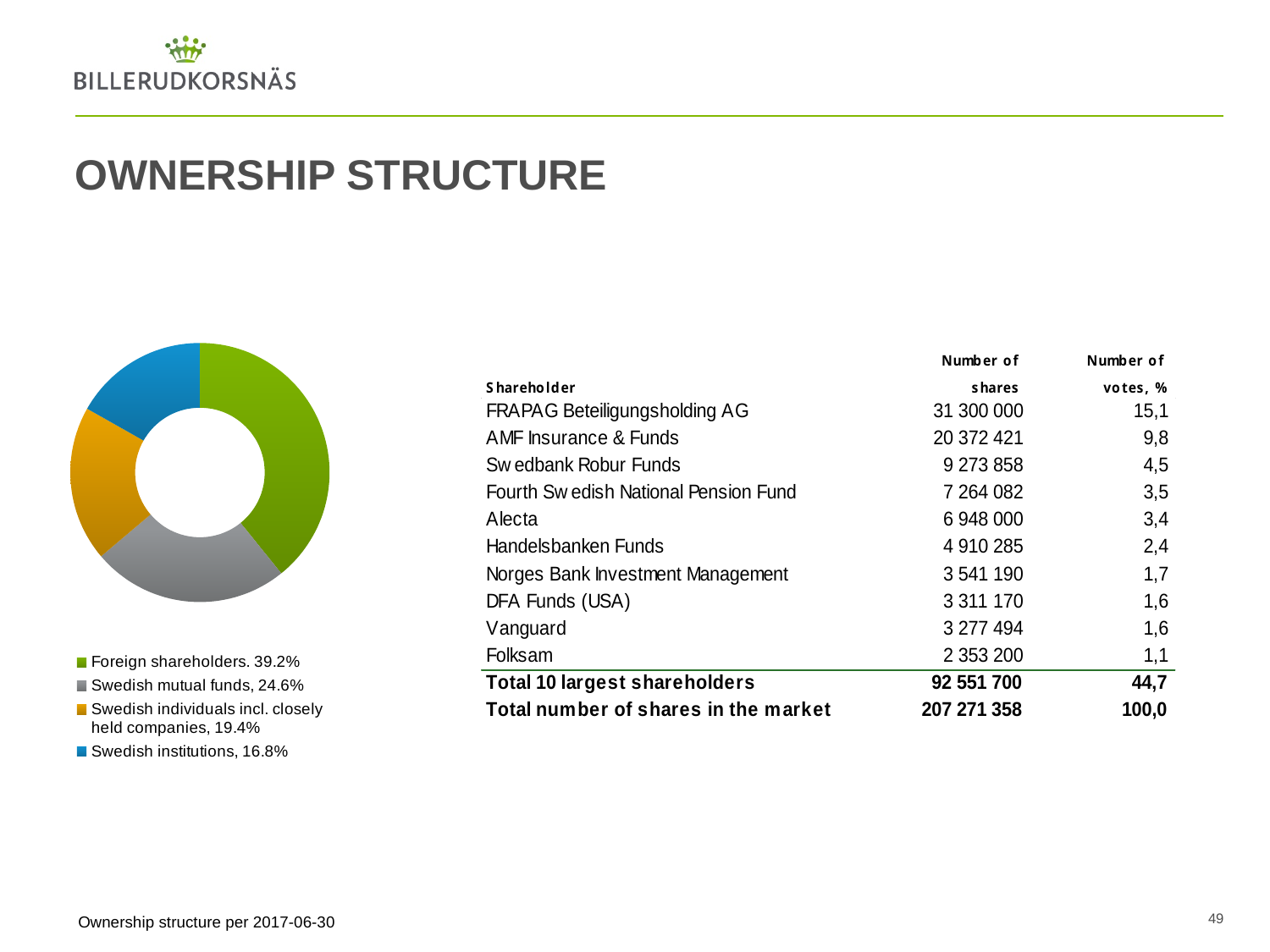
How many categories does the donut chart show? 4 What share of the donut chart is Swedish mutual funds? 24.6% What is the difference in percentage points between Foreign shareholders and Swedish mutual funds in the donut chart? 14.6 percentage points What colour represents Swedish institutions in the donut chart? Blue What share of the donut chart is Swedish individuals incl. closely held companies? 19.4% What share of the donut chart is Swedish institutions? 16.8% Which category has the largest share in the donut chart? Foreign shareholders Which category has the smallest share in the donut chart? Swedish institutions What is the difference in percentage points between Foreign shareholders and Swedish institutions in the donut chart? 22.4 percentage points In the donut chart, which is larger: Swedish mutual funds or Swedish individuals incl. closely held companies? Swedish mutual funds What kind of chart is shown on the left of the slide? Donut (pie) chart What share of the donut chart is Foreign shareholders? 39.2%